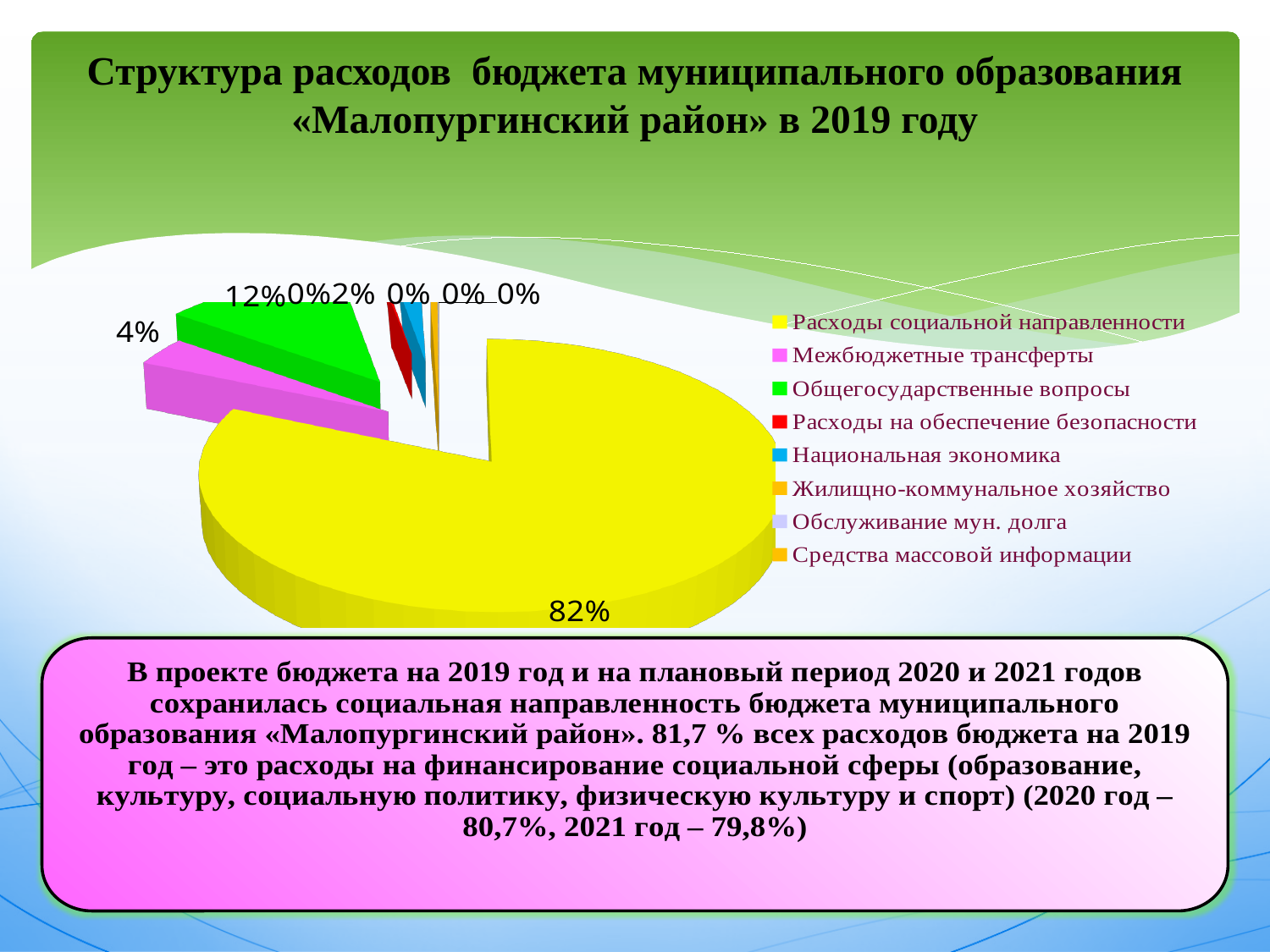
Which category has the largest share of the pie? Расходы социальной направленности By how many percentage points does the share for Расходы социальной направленности exceed the share for Общегосударственные вопросы? 70 How many categories does the legend of the pie chart list? 8 What percentage is shown for Межбюджетные трансферты? 4% By how many percentage points does the share for Общегосударственные вопросы exceed the share for Межбюджетные трансферты? 8 What kind of chart is shown on the slide? pie chart What percentage is shown for Общегосударственные вопросы? 12% What share of the pie is labelled for Расходы социальной направленности? 82% What percentage is shown for Национальная экономика? 2% Which is larger: the share for Общегосударственные вопросы or the share for Межбюджетные трансферты? Общегосударственные вопросы What colour is the largest slice of the pie chart? yellow Which year does the chart title say the budget expenditure structure refers to? 2019